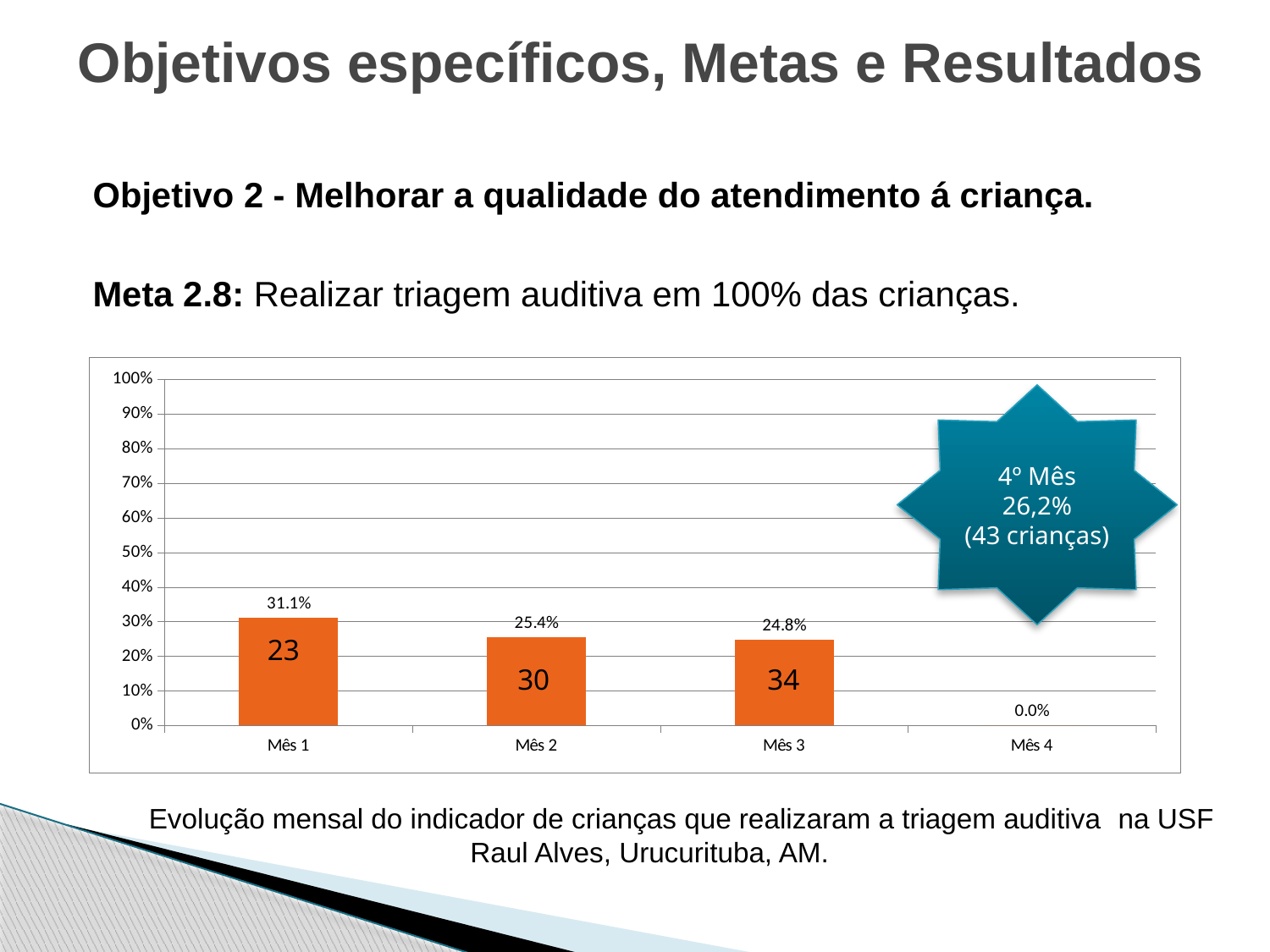
Which month has the highest percentage in the chart? Mês 1 Which month has the lowest percentage in the chart? Mês 4 What number is printed inside the bar for Mês 3? 34 What type of chart is shown on the slide? bar chart What is the difference in percentage points between Mês 1 and Mês 2? 5.7 How many months are shown on the x axis of the chart? 4 What percentage is shown for Mês 1? 31.1% What percentage is shown for Mês 3? 24.8% What percentage does the star-shaped callout on the chart give for the 4º Mês? 26,2% Is the value for Mês 1 greater or less than 40%? less What number is printed inside the bar for Mês 2? 30 Which is larger, the percentage for Mês 2 or for Mês 3? Mês 2